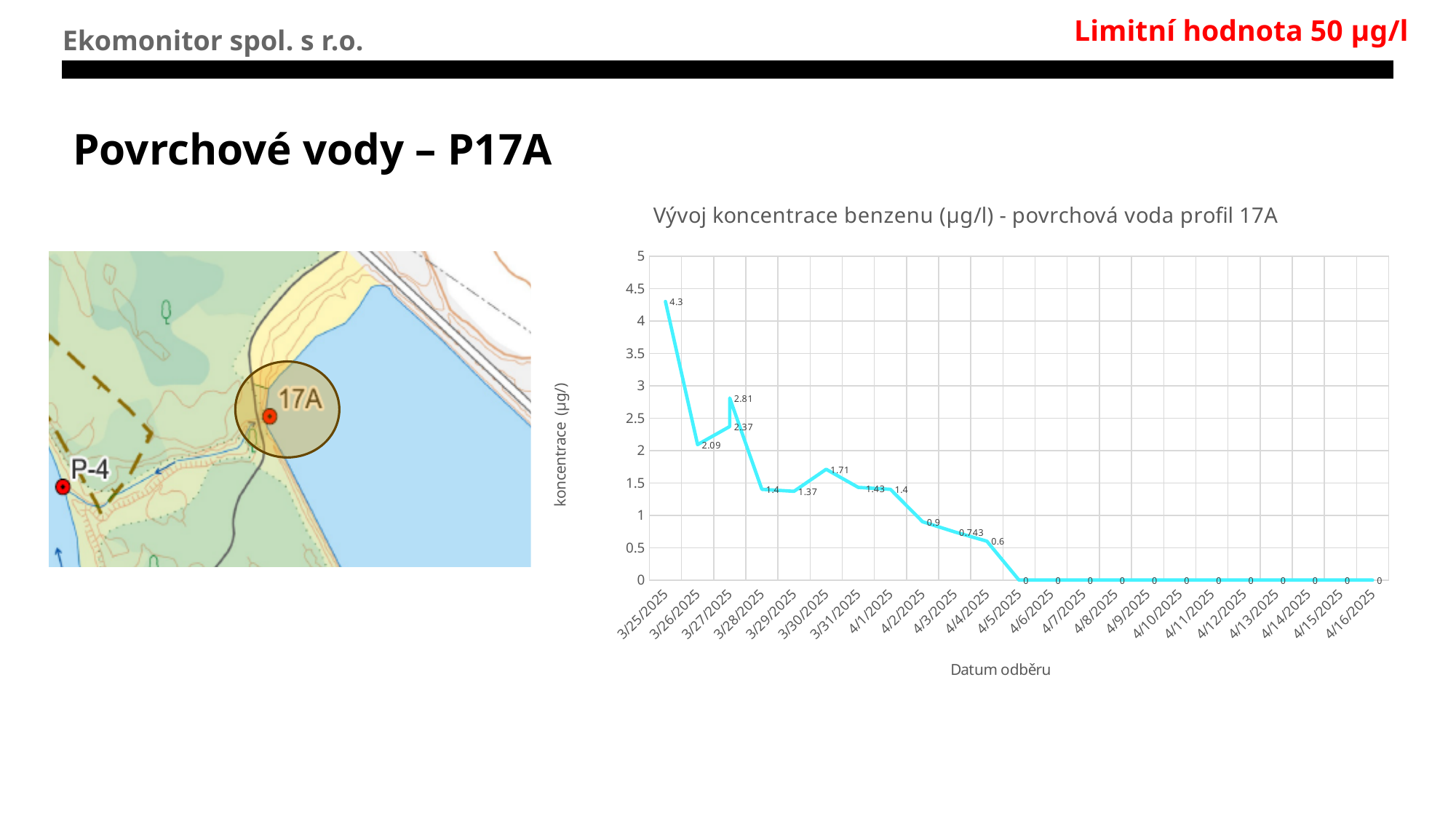
What is the value plotted for 3/26/2025? 2.09 Which date has the larger value, 3/30/2025 or 3/31/2025? 3/30/2025 What is the benzene concentration value plotted for 3/25/2025? 4.3 What is the value plotted for 4/10/2025? 0 What is the difference between the values for 4/3/2025 and 4/4/2025? 0.143 What is the label of the y axis of the chart? koncentrace (µg/l) What is the difference between the values for 3/25/2025 and 3/26/2025? 2.21 On which date is the plotted concentration highest? 3/25/2025 What kind of chart is shown on the slide? line chart Do the plotted values generally rise or fall from left to right along the x axis? fall What is the value plotted for 3/30/2025? 1.71 What is the value plotted for 4/3/2025? 0.743